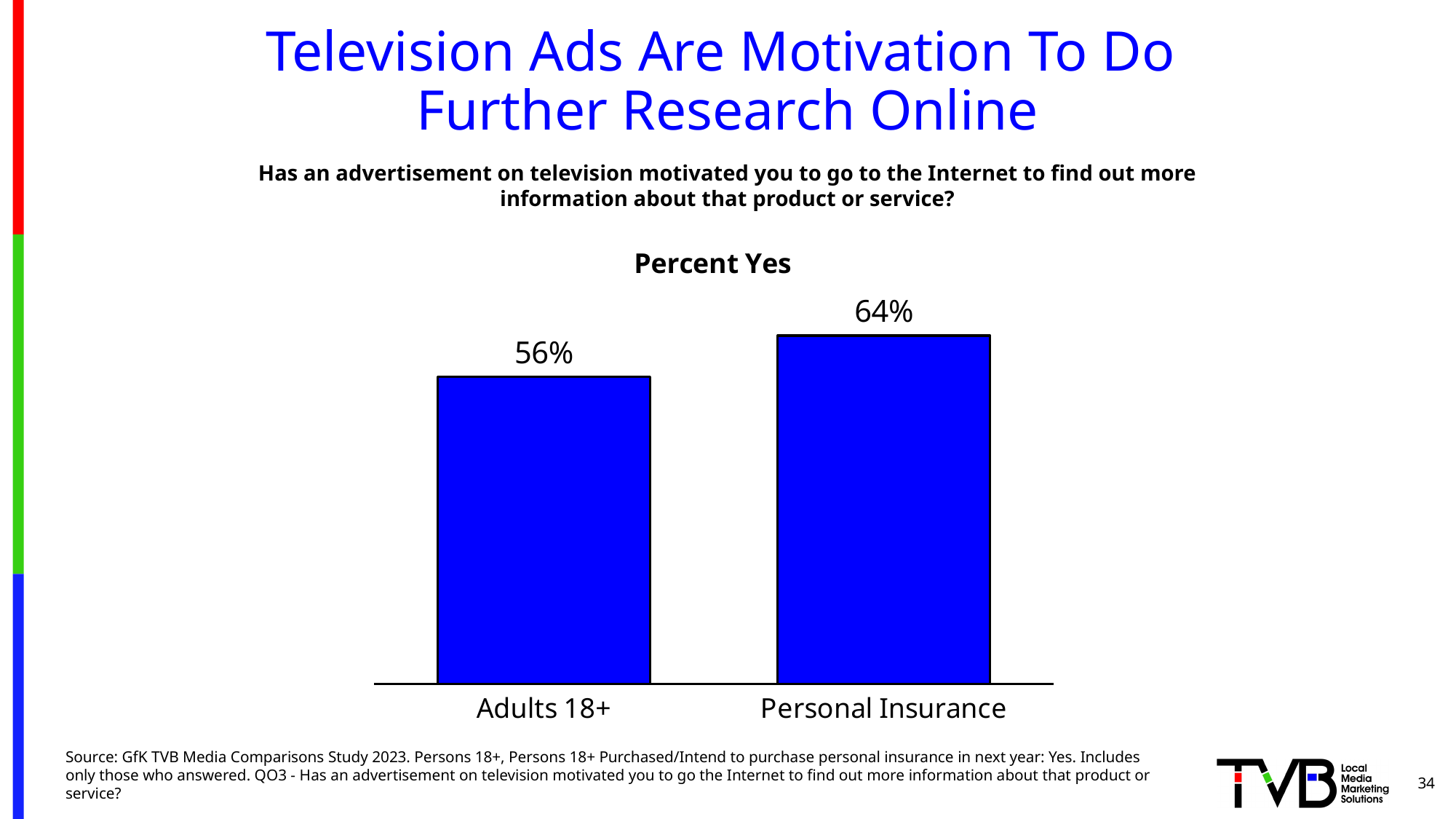
Which is larger, the Percent Yes for Adults 18+ or for Personal Insurance? Personal Insurance What is the title of the chart? Percent Yes What is the Percent Yes value for Personal Insurance? 64% What is the difference in Percent Yes between Personal Insurance and Adults 18+? 8% How many categories are shown in the chart? 2 Which category has the lowest Percent Yes value? Adults 18+ What kind of chart is shown on the slide? Bar chart What is the Percent Yes value for Adults 18+? 56% What colour are the bars in the chart? Blue Which category has the highest Percent Yes value? Personal Insurance Do the values rise or fall from Adults 18+ to Personal Insurance? Rise